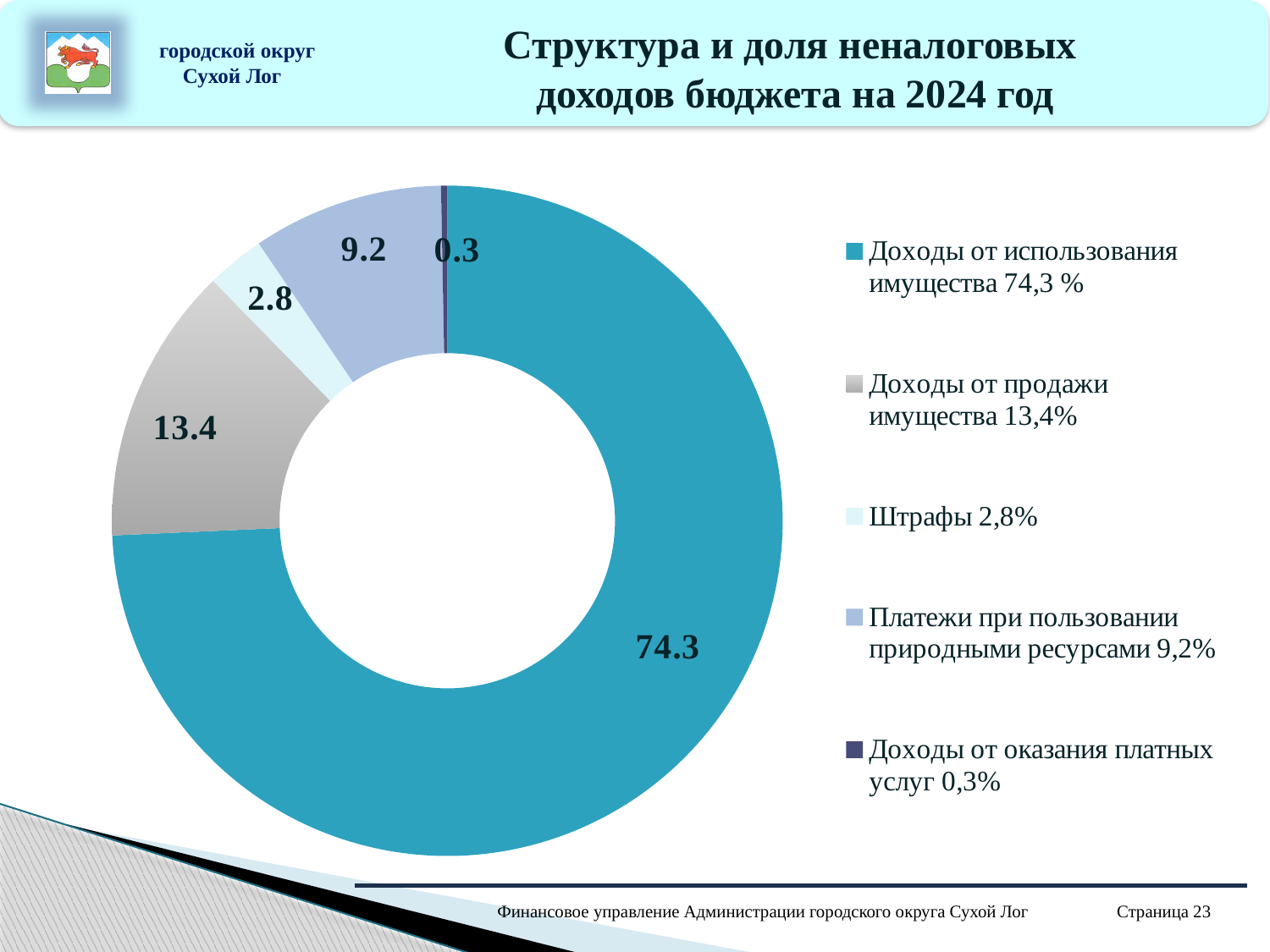
What is the data label for the slice 'Доходы от продажи имущества'? 13.4 Which category has the smallest slice of the chart? Доходы от оказания платных услуг What kind of chart is shown on the slide? Pie chart (doughnut) What is the data label for the slice 'Штрафы'? 2.8 Which category has the largest slice of the chart? Доходы от использования имущества What is the title of the slide containing the chart? Структура и доля неналоговых доходов бюджета на 2024 год What is the difference between the values for 'Доходы от продажи имущества' and 'Платежи при пользовании природными ресурсами'? 4.2 How many slices does the chart have? 5 What is the data label for the slice 'Платежи при пользовании природными ресурсами'? 9.2 What is the data label for the slice 'Доходы от использования имущества'? 74.3 Which is larger: the value for 'Штрафы' or the value for 'Платежи при пользовании природными ресурсами'? Платежи при пользовании природными ресурсами What is the data label for the slice 'Доходы от оказания платных услуг'? 0.3